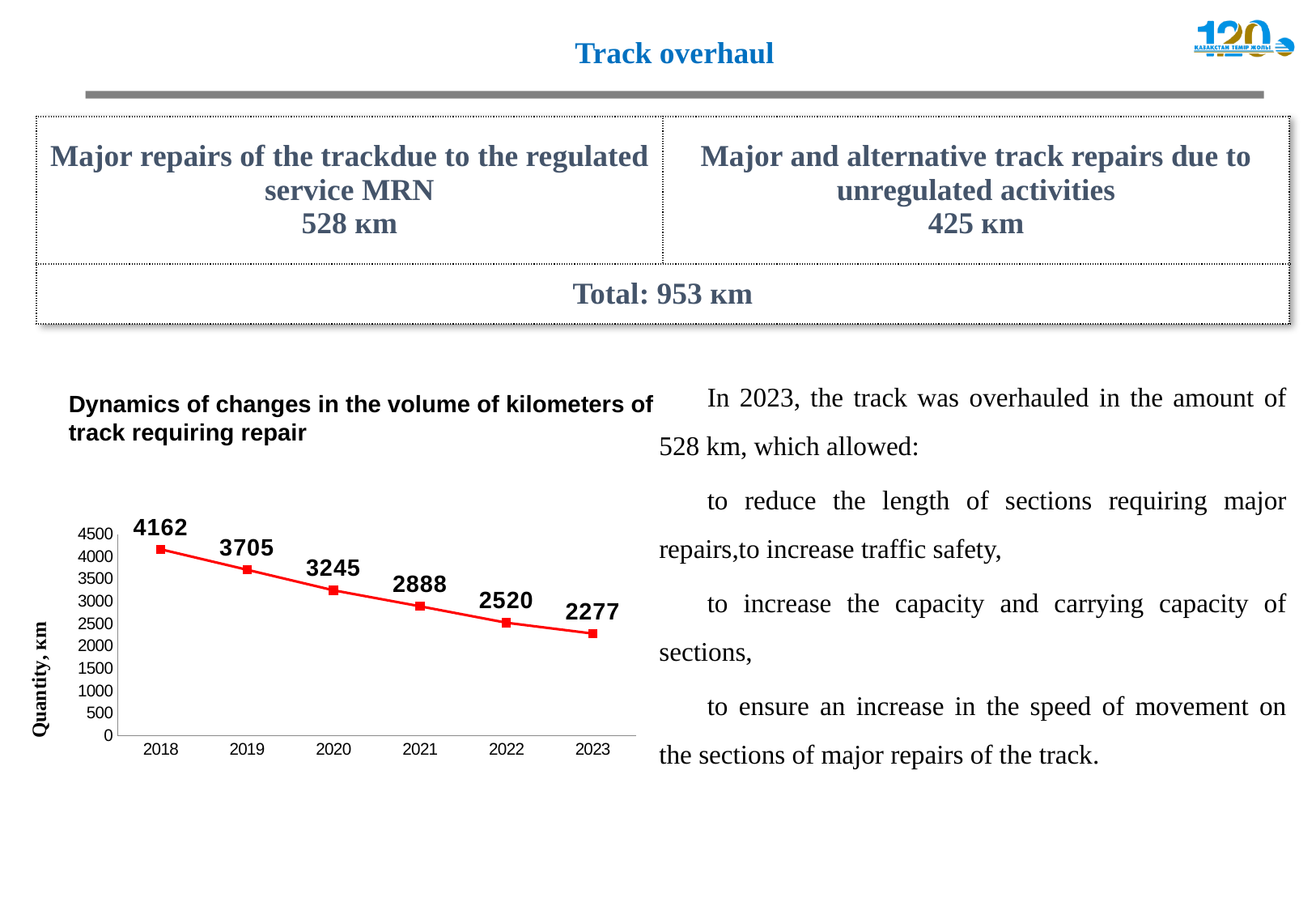
Which year has the lowest value in the chart? 2023 What is the value for 2023 in the chart? 2277 What is the difference between the values for 2019 and 2020? 460 Which year has the highest value in the chart? 2018 How many years are plotted in the chart? 6 What is the value for 2021 in the chart? 2888 What is the difference between the values for 2018 and 2023? 1885 What kind of chart is shown on the slide? line chart Do the values rise or fall from 2018 to 2023? fall Which is larger, the value for 2020 or the value for 2022? 2020 Is the value for 2021 greater or less than 3000? less What is the value for 2018 in the chart? 4162